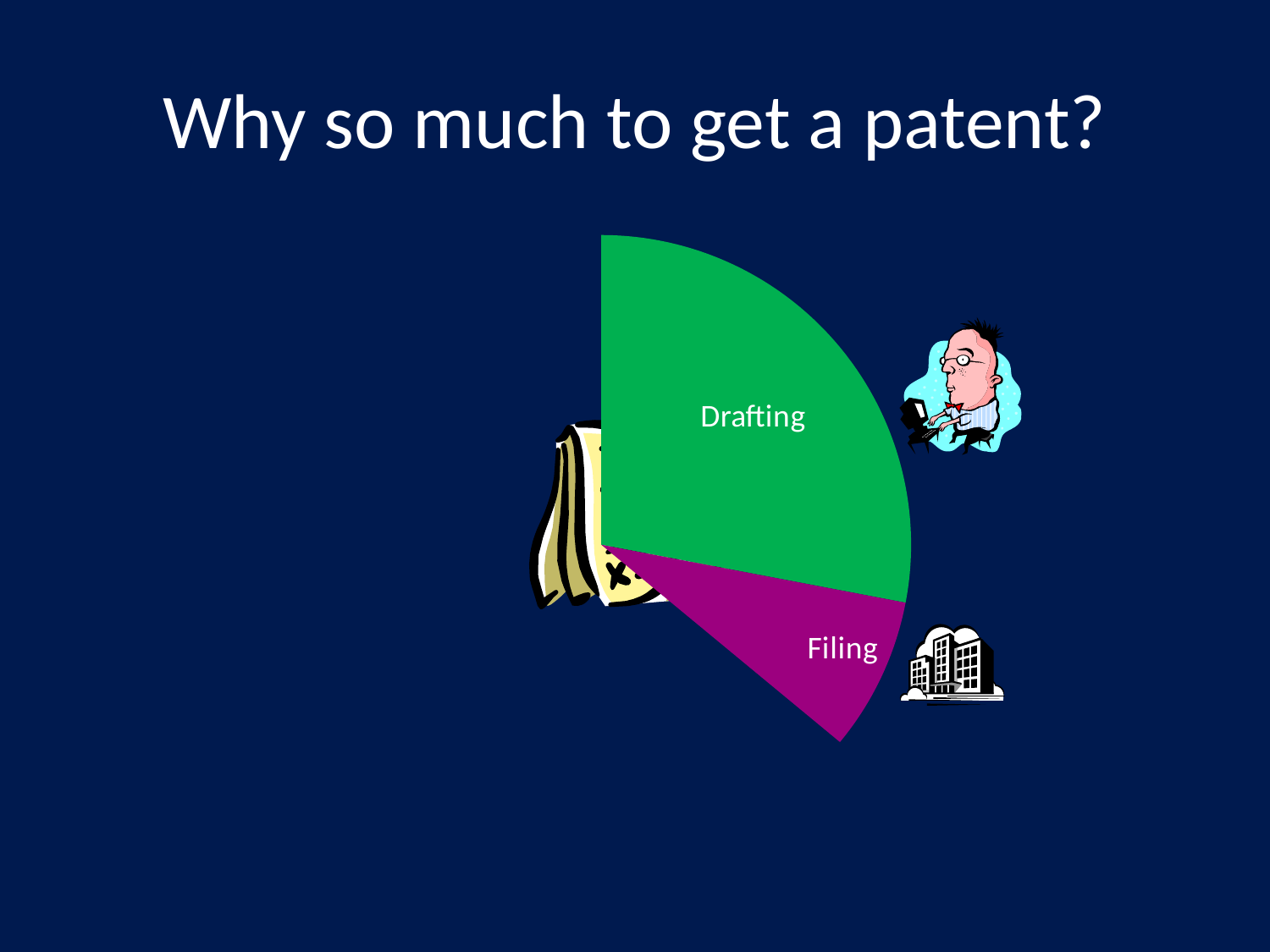
How many labeled slices does the pie chart show? 2 What kind of chart is shown on the slide? pie chart Which labeled slice of the pie chart is the largest? Drafting Which labeled slice of the pie chart is the smallest? Filing Which slice is larger, Drafting or Filing? Drafting What colour is the Drafting slice? green What is the title of the slide containing the pie chart? Why so much to get a patent?